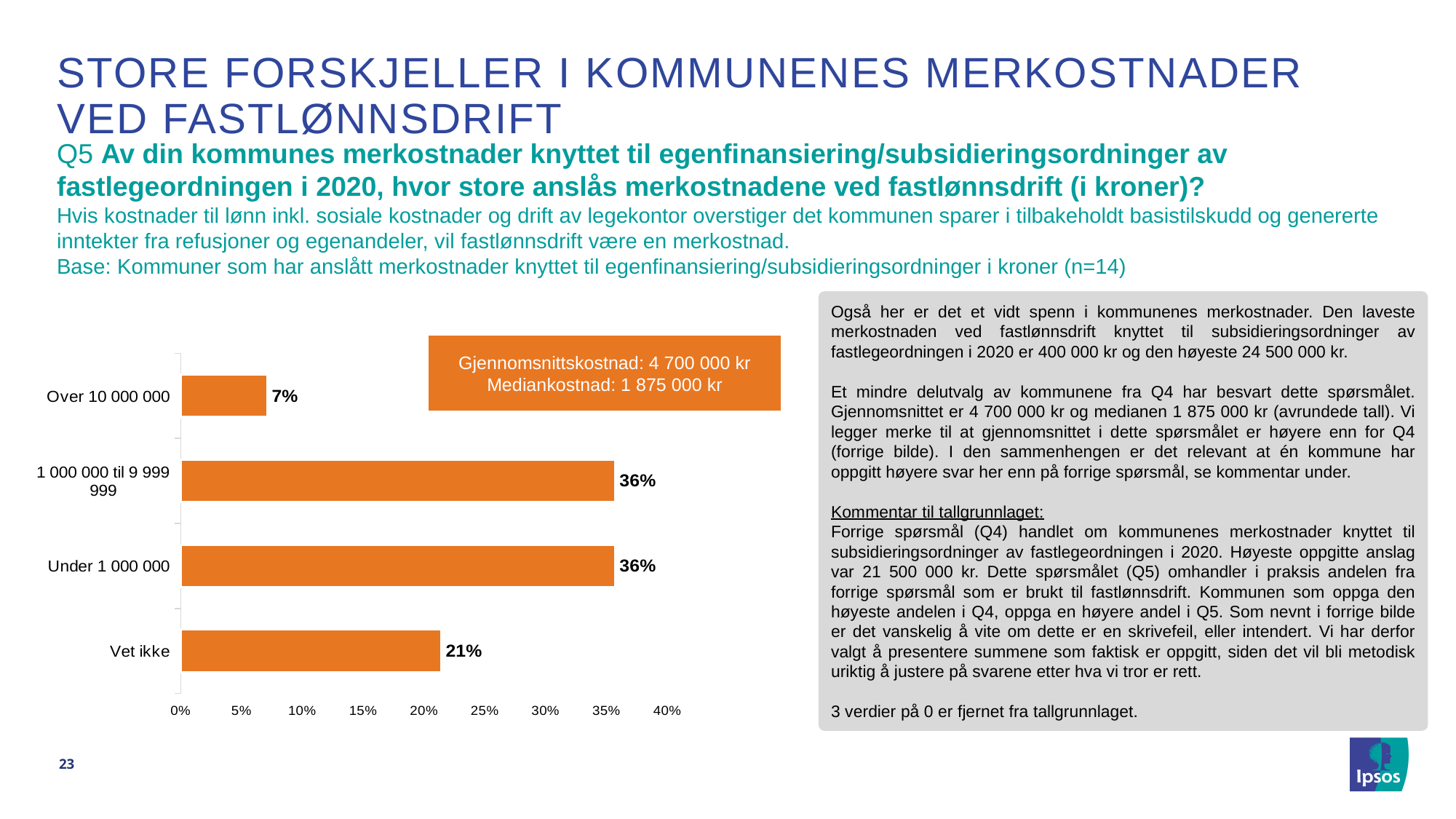
What is the difference in percentage points between "Vet ikke" and "Over 10 000 000"? 14 percentage points What type of chart is shown on the slide? Bar chart What percentage is shown for "Under 1 000 000"? 36% What percentage of municipalities answered "Over 10 000 000"? 7% Is the value for "Vet ikke" greater or less than 25%? less What is the value shown for "Vet ikke"? 21% What median cost (Mediankostnad) is stated in the box on the chart? 1 875 000 kr How many categories are shown in the bar chart? 4 What is the value for the category "1 000 000 til 9 999 999"? 36% Which is larger, the value for "Vet ikke" or the value for "Over 10 000 000"? Vet ikke What is the difference in percentage points between "Under 1 000 000" and "Over 10 000 000"? 29 percentage points Which category has the lowest percentage? Over 10 000 000